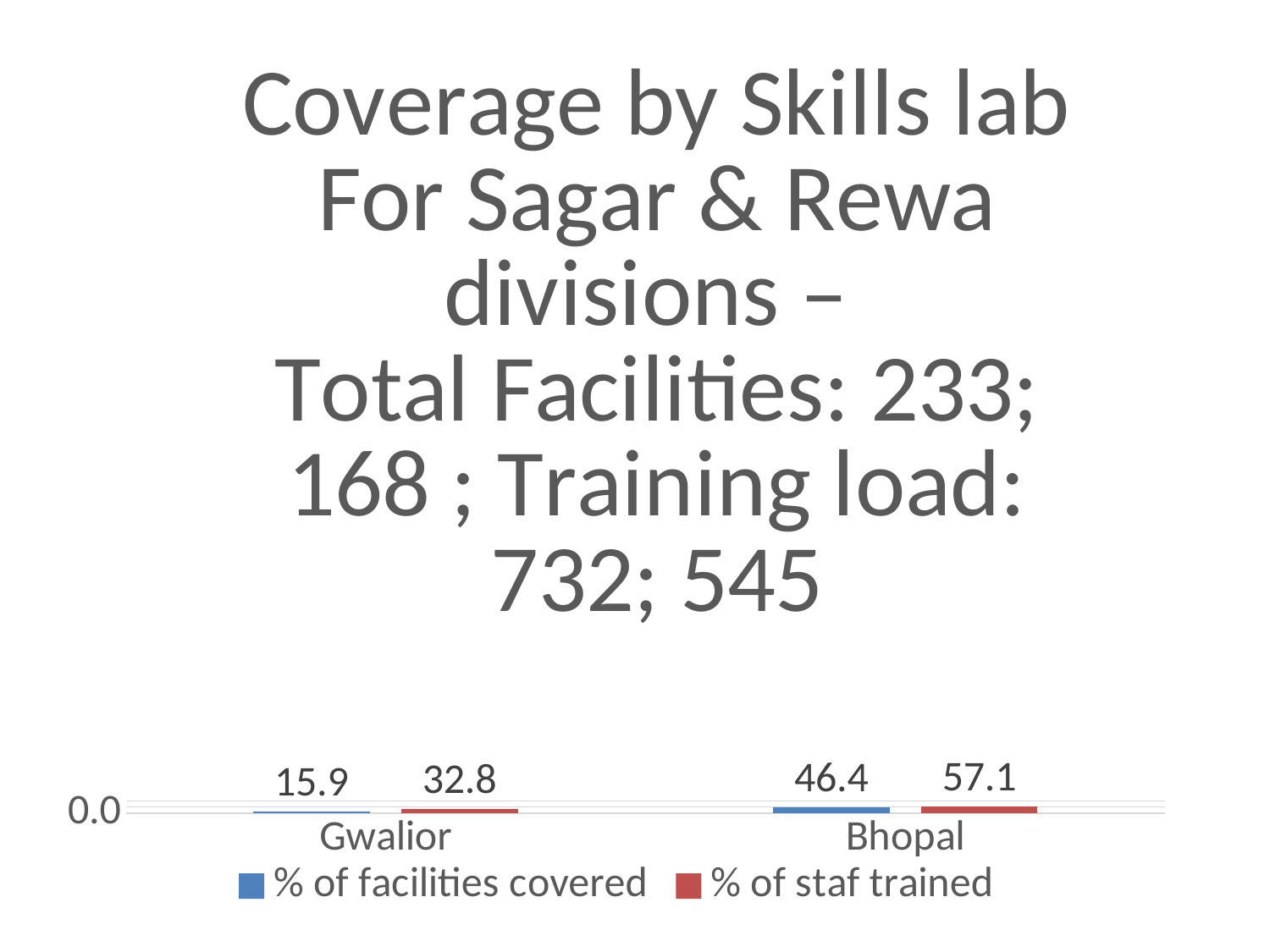
What kind of chart is shown on the slide? Bar chart Which is larger for Gwalior: % of facilities covered or % of staf trained? % of staf trained What is the value of % of staf trained for Bhopal? 57.1 Which category has the lowest value for % of facilities covered? Gwalior How many series does the chart legend list? 2 How many categories are shown on the x axis of the chart? 2 What is the difference in % of facilities covered between Bhopal and Gwalior? 30.5 Which category has the highest value for % of staf trained? Bhopal What is the difference between % of staf trained and % of facilities covered for Bhopal? 10.7 What is the value of % of facilities covered for Bhopal? 46.4 What is the value of % of facilities covered for Gwalior? 15.9 What is the value of % of staf trained for Gwalior? 32.8